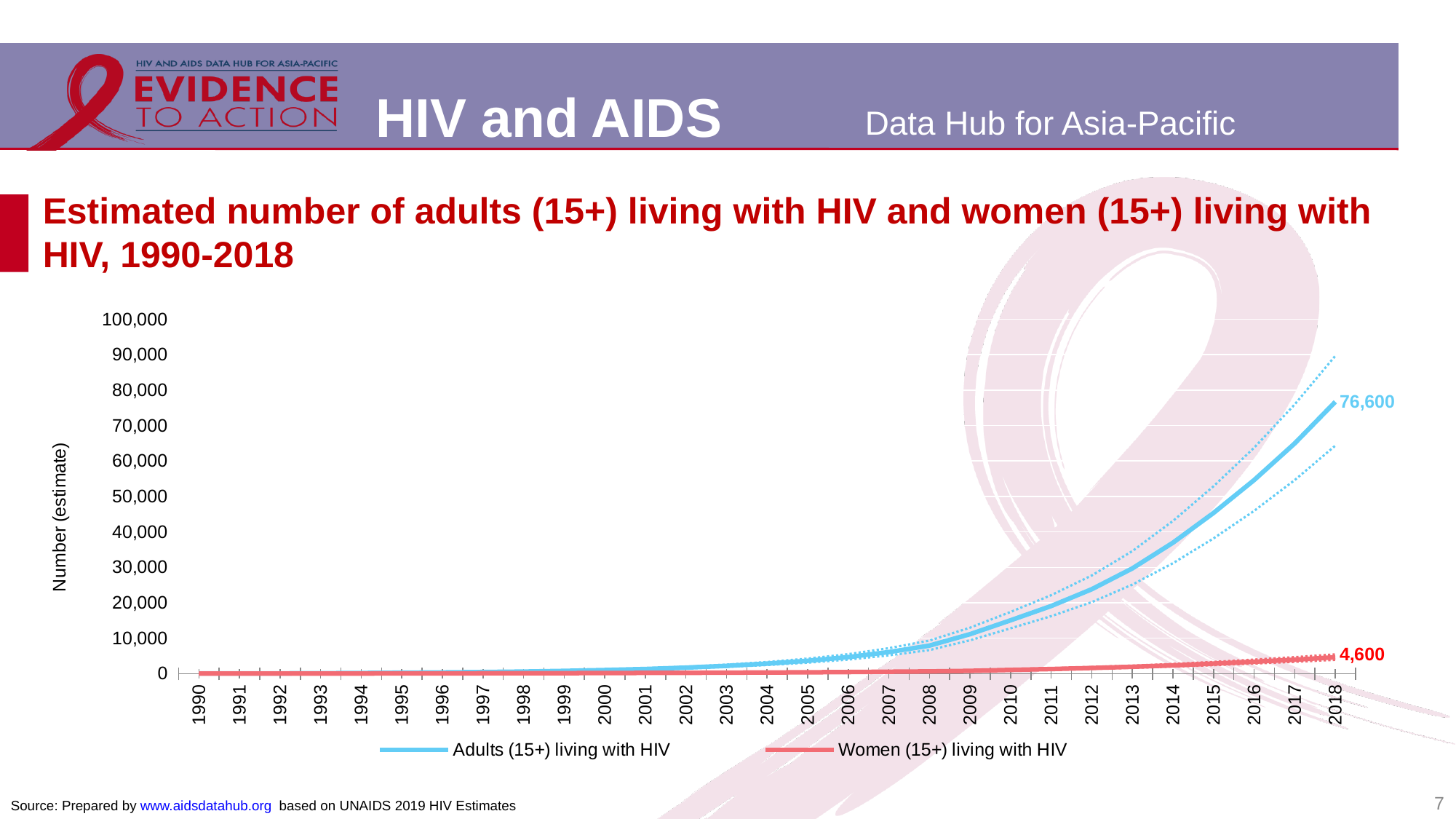
Does the number of adults (15+) living with HIV rise or fall from 1990 to 2018? Rise What is the label on the y axis of the chart? Number (estimate) How many years are shown on the x axis of the chart? 29 What is the difference between the number of adults (15+) living with HIV and women (15+) living with HIV in 2018? 72,000 What kind of chart is shown on the slide? Line chart Is the value for adults (15+) living with HIV in 2016 greater or less than 40,000? greater What is the estimated number of women (15+) living with HIV in 2018? 4,600 Is the value for adults (15+) living with HIV in 2000 greater or less than 10,000? less In 2018, which is larger: the number of adults (15+) living with HIV or the number of women (15+) living with HIV? Adults (15+) living with HIV How many series does the legend list? 2 What is the estimated number of adults (15+) living with HIV in 2018? 76,600 Is the value for women (15+) living with HIV in 2018 greater or less than 10,000? less